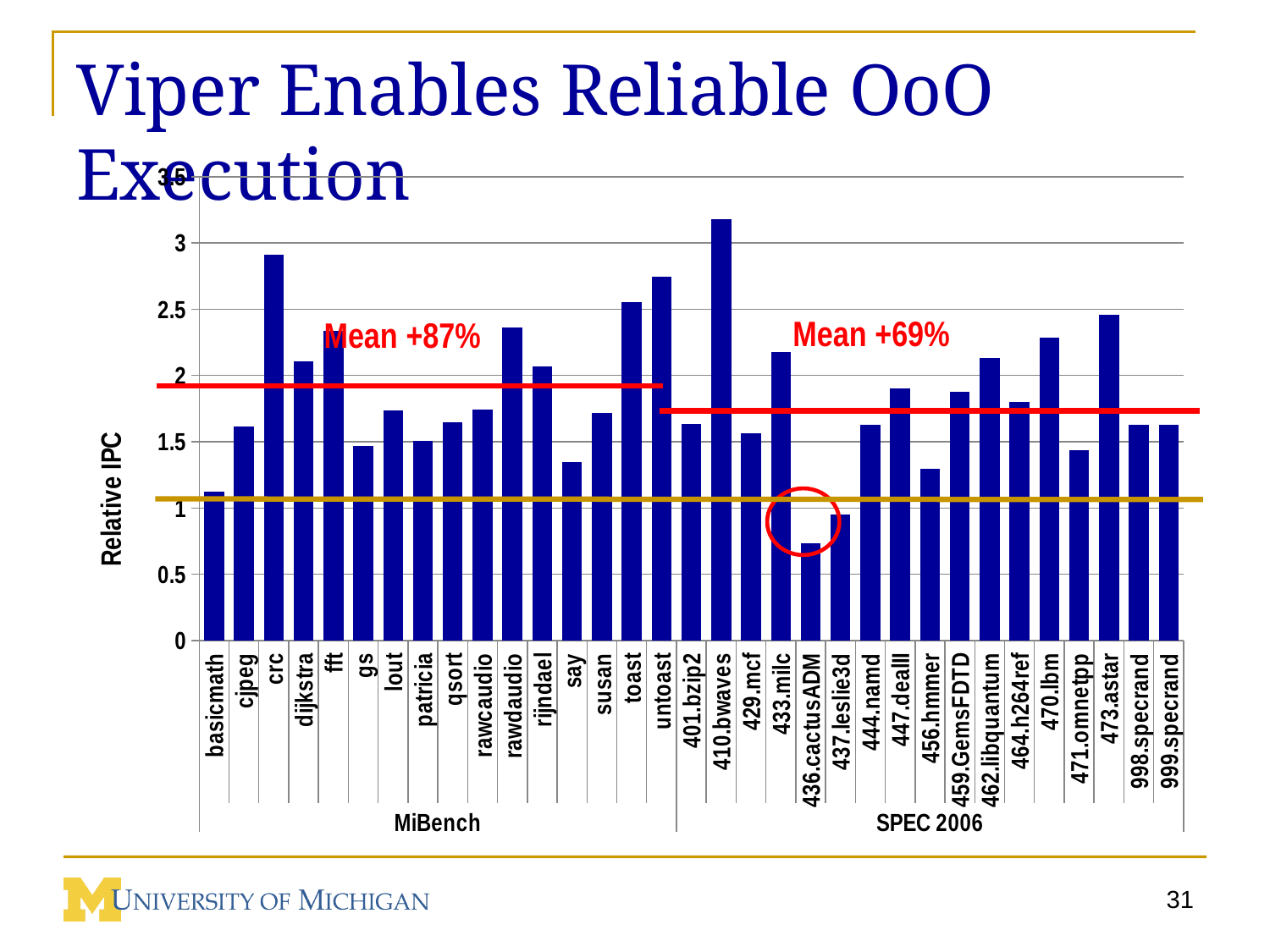
What is the mean improvement annotated for the SPEC 2006 group? Mean +69% What kind of chart is shown on the slide? bar chart Is the Relative IPC for say greater or less than 1.5? less Is the Relative IPC for 473.astar greater or less than 2? greater Is the Relative IPC for 436.cactusADM greater or less than 1? less Which has a higher Relative IPC, crc or dijkstra? crc Which has a higher Relative IPC, 410.bwaves or 473.astar? 410.bwaves What is the label of the y axis? Relative IPC Which benchmark has the lowest Relative IPC? 436.cactusADM Which benchmark has the highest Relative IPC? 410.bwaves How many benchmarks are plotted in the MiBench group? 16